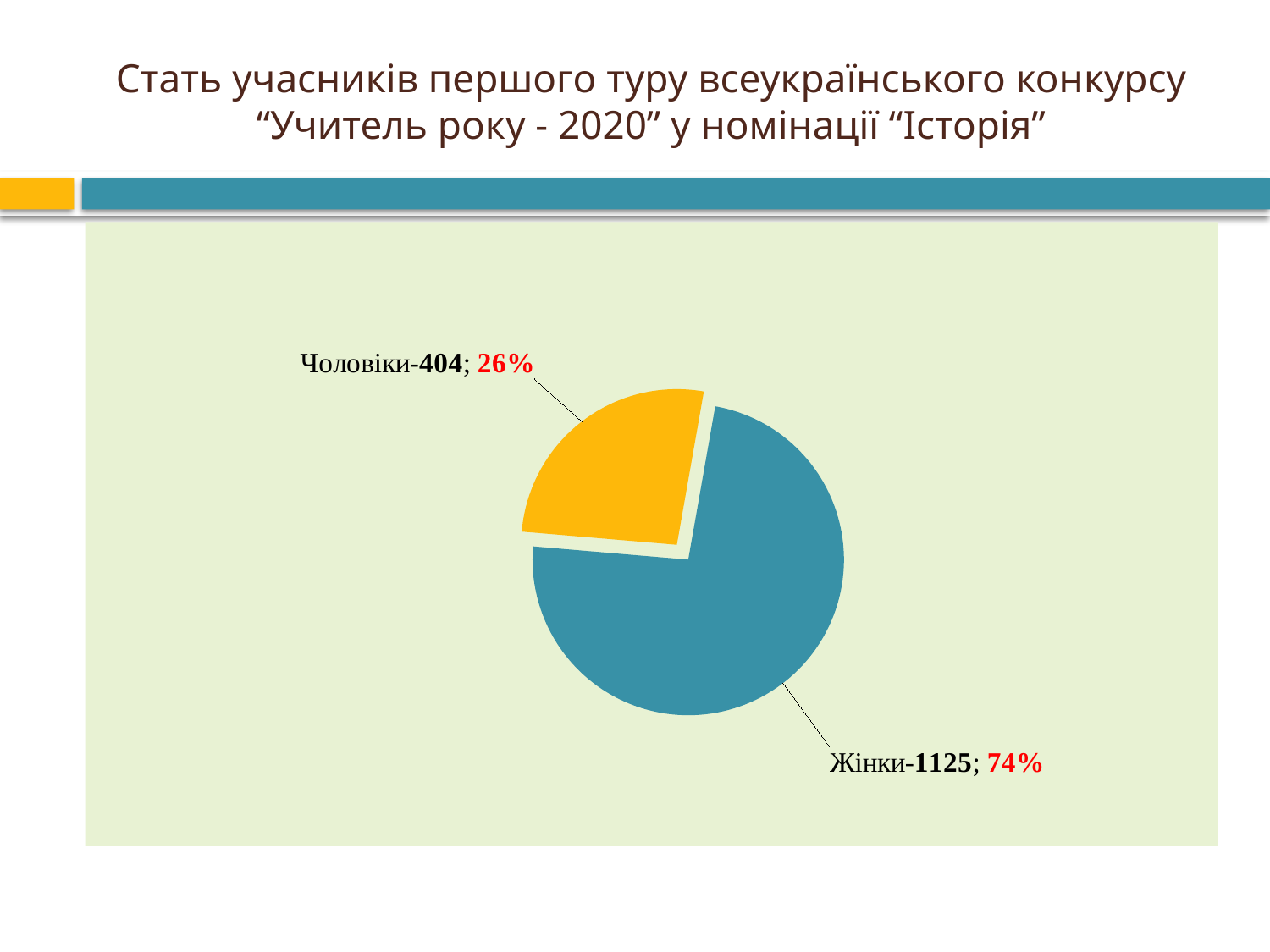
What share of the pie does the Жінки slice represent? 74% Which category has the smallest slice? Чоловіки What is the difference between the values for Жінки and Чоловіки? 721 What share of the pie does the Чоловіки slice represent? 26% How many slices does the pie chart have? 2 What kind of chart is shown on the slide? pie chart Which category has the largest slice? Жінки What colour is the Чоловіки slice? yellow What is the value for Чоловіки? 404 What is the total of the two values shown in the pie chart? 1529 Which is larger, the value for Жінки or the value for Чоловіки? Жінки What is the value for Жінки? 1125